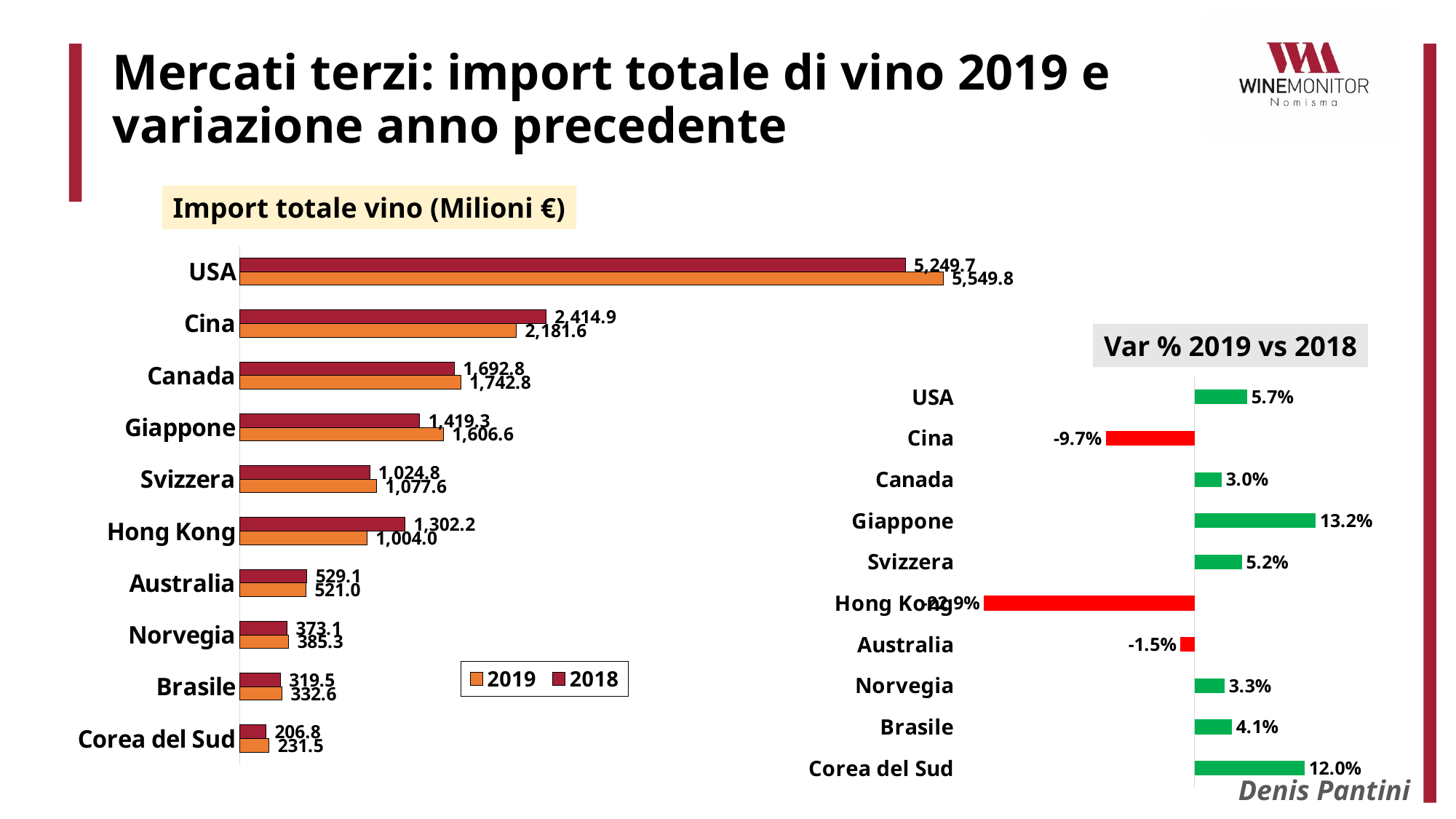
In the 'Import totale vino (Milioni €)' chart, what is the difference between the 2019 and 2018 values for Giappone? 187.3 In the 'Var % 2019 vs 2018' chart, what is the value for Giappone? 13.2% In the 'Import totale vino (Milioni €)' chart, which country has the highest 2019 import value? USA In the 'Var % 2019 vs 2018' chart, which country has the lowest value? Hong Kong How many series does the legend of the 'Import totale vino (Milioni €)' chart list? 2 In the 'Import totale vino (Milioni €)' chart, what is the 2019 value for USA? 5,549.8 In the 'Import totale vino (Milioni €)' chart, what is the 2019 value for Hong Kong? 1,004.0 How many countries are shown in the 'Var % 2019 vs 2018' chart? 10 In the 'Import totale vino (Milioni €)' chart, which country has the lowest 2018 import value? Corea del Sud What type of chart is the 'Var % 2019 vs 2018' chart? bar chart In the 'Import totale vino (Milioni €)' chart, is the 2019 value for Canada larger or smaller than the 2018 value for Canada? larger In the 'Import totale vino (Milioni €)' chart, what is the 2018 value for Cina? 2,414.9